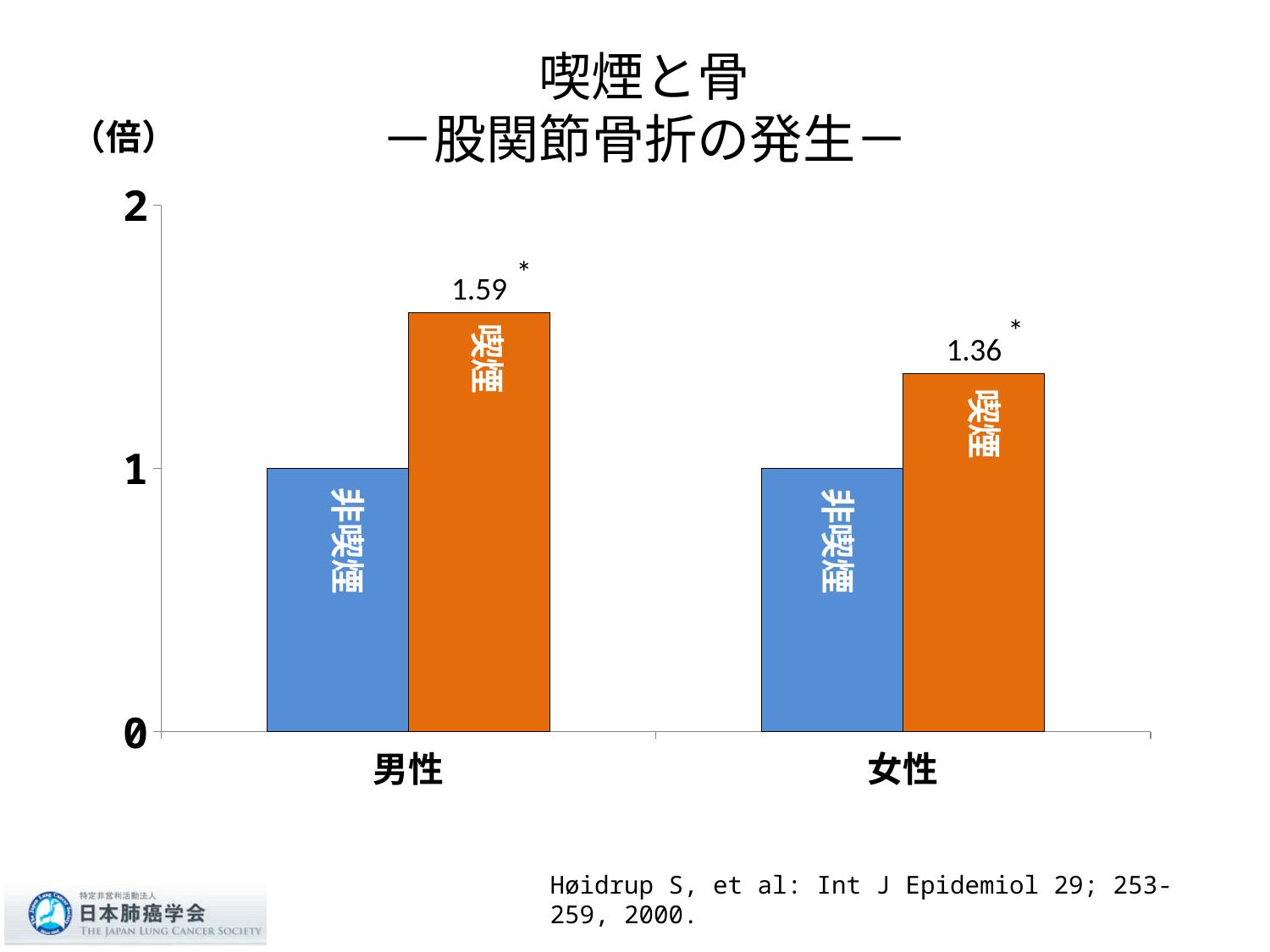
Is the value for 喫煙 in the 女性 group greater or less than 1? greater What is the difference between the 喫煙 and 非喫煙 values in the 男性 group? 0.59 What is the value for 喫煙 in the 男性 group? 1.59 What is the difference between the 喫煙 values for 男性 and 女性? 0.23 What unit is shown at the top of the y axis? 倍 What is the value for 非喫煙 in the 男性 group? 1 What is the value for 喫煙 in the 女性 group? 1.36 How many groups are shown on the x axis? 2 What kind of chart is shown on the slide? bar chart Which bar has the highest value on the chart? 男性 喫煙 How many series (bar types) are shown in each group? 2 Which group has the higher 喫煙 value, 男性 or 女性? 男性